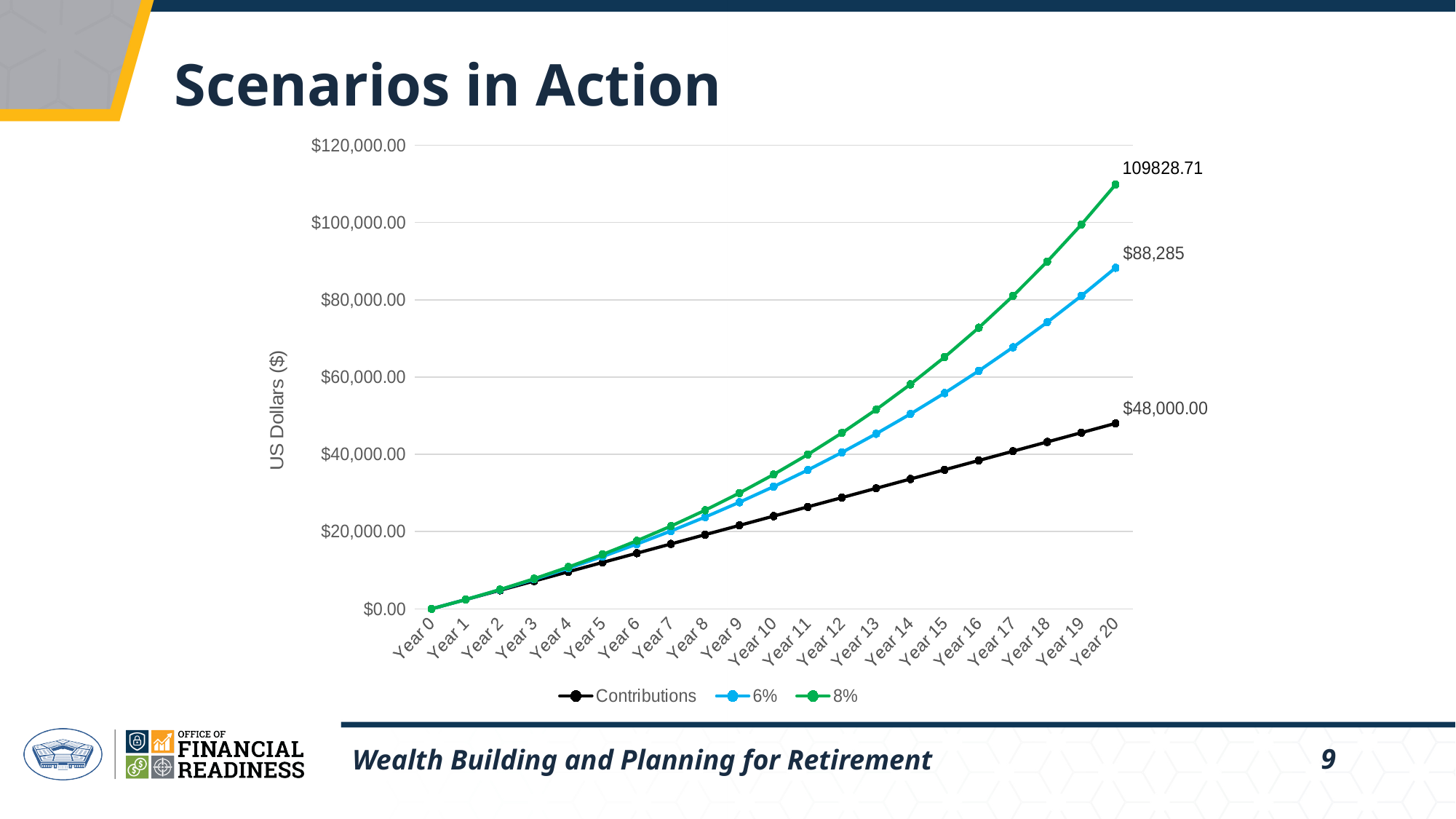
What is the value of the Contributions series at Year 20? $48,000.00 Is the value of the Contributions series at Year 10 greater or less than $20,000? greater How many year points are plotted along the x axis? 21 Which series has the lowest value at Year 20? Contributions What is the value of the 8% series at Year 20? 109828.71 Is the value of the 8% series at Year 10 greater or less than $40,000? less What is the value of the 6% series at Year 20? $88,285 What kind of chart is shown on the slide? Line chart How many series does the legend list? 3 Which series has the highest value at Year 20? 8% At Year 20, which is larger: the 6% series or the Contributions series? 6% At Year 20, how much larger is the 6% series than the Contributions series? $40,285